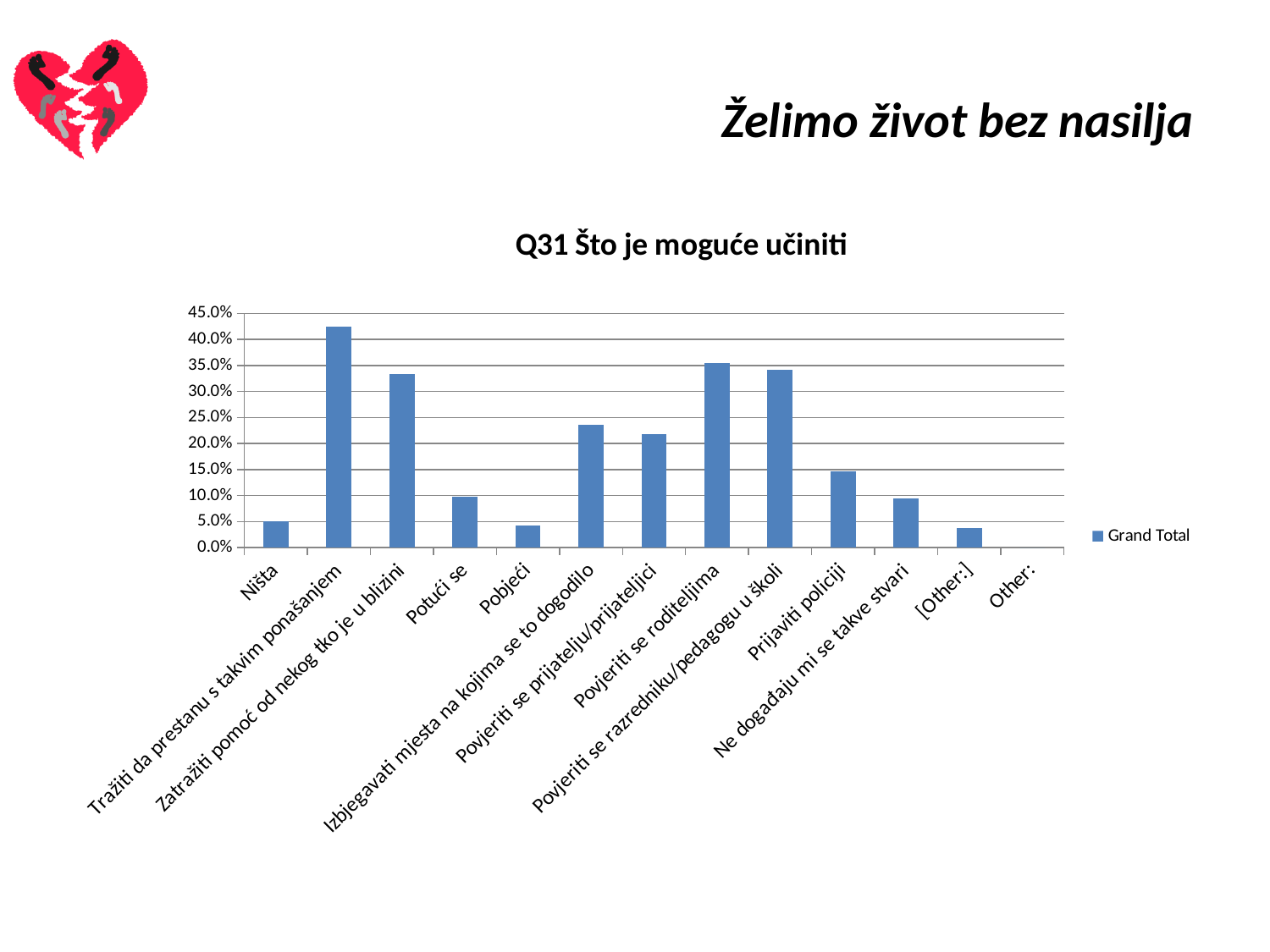
How many series does the legend list? 1 Is the value for Tražiti da prestanu s takvim ponašanjem greater or less than 40.0%? greater What is the name of the series in the legend? Grand Total Is the value for Ništa greater or less than 10.0%? less Is the value for Povjeriti se roditeljima greater or less than 30.0%? greater How many categories are shown on the x axis? 13 Which is larger, the value for Prijaviti policiji or the value for Potući se? Prijaviti policiji What is the title of the chart? Q31 Što je moguće učiniti Which category has the highest value? Tražiti da prestanu s takvim ponašanjem Which is larger, the value for Zatražiti pomoć od nekog tko je u blizini or the value for Izbjegavati mjesta na kojima se to dogodilo? Zatražiti pomoć od nekog tko je u blizini What kind of chart is shown on the slide? bar chart